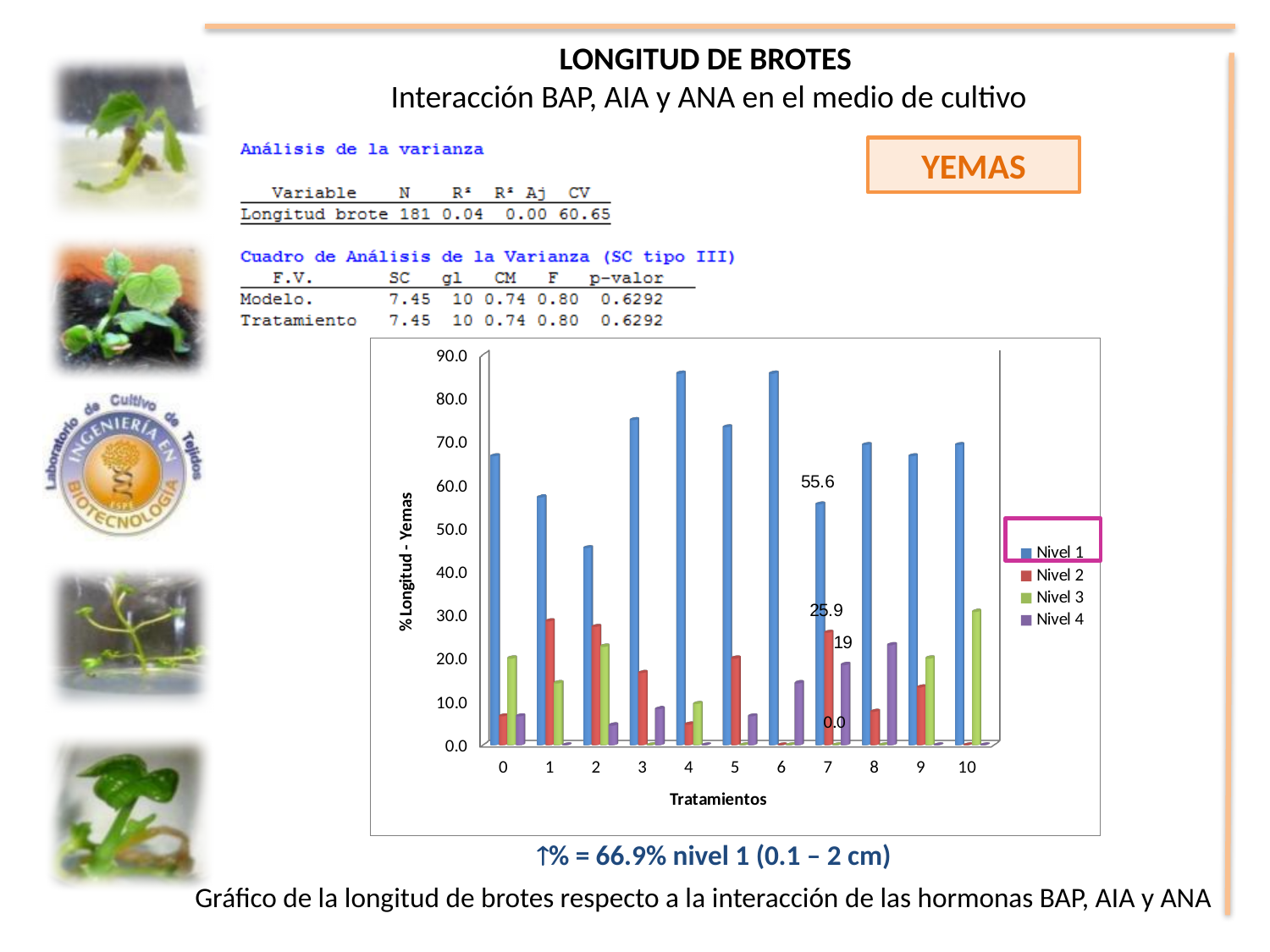
Is the Nivel 1 value for treatment 2 greater or less than 50.0? less What is the value of Nivel 4 for treatment 7? 19 How many treatments are shown on the x axis? 11 Which treatment has the lowest Nivel 1 value? 2 How many series does the legend list? 4 Is the Nivel 1 value for treatment 4 greater or less than 80.0? greater What is the difference between the Nivel 1 and Nivel 2 values for treatment 7? 29.7 What is the value of Nivel 2 for treatment 7? 25.9 What is the value of Nivel 3 for treatment 7? 0.0 For treatment 7, which is larger: Nivel 2 or Nivel 4? Nivel 2 What kind of chart is shown on the slide? bar chart What is the value of Nivel 1 for treatment 7? 55.6